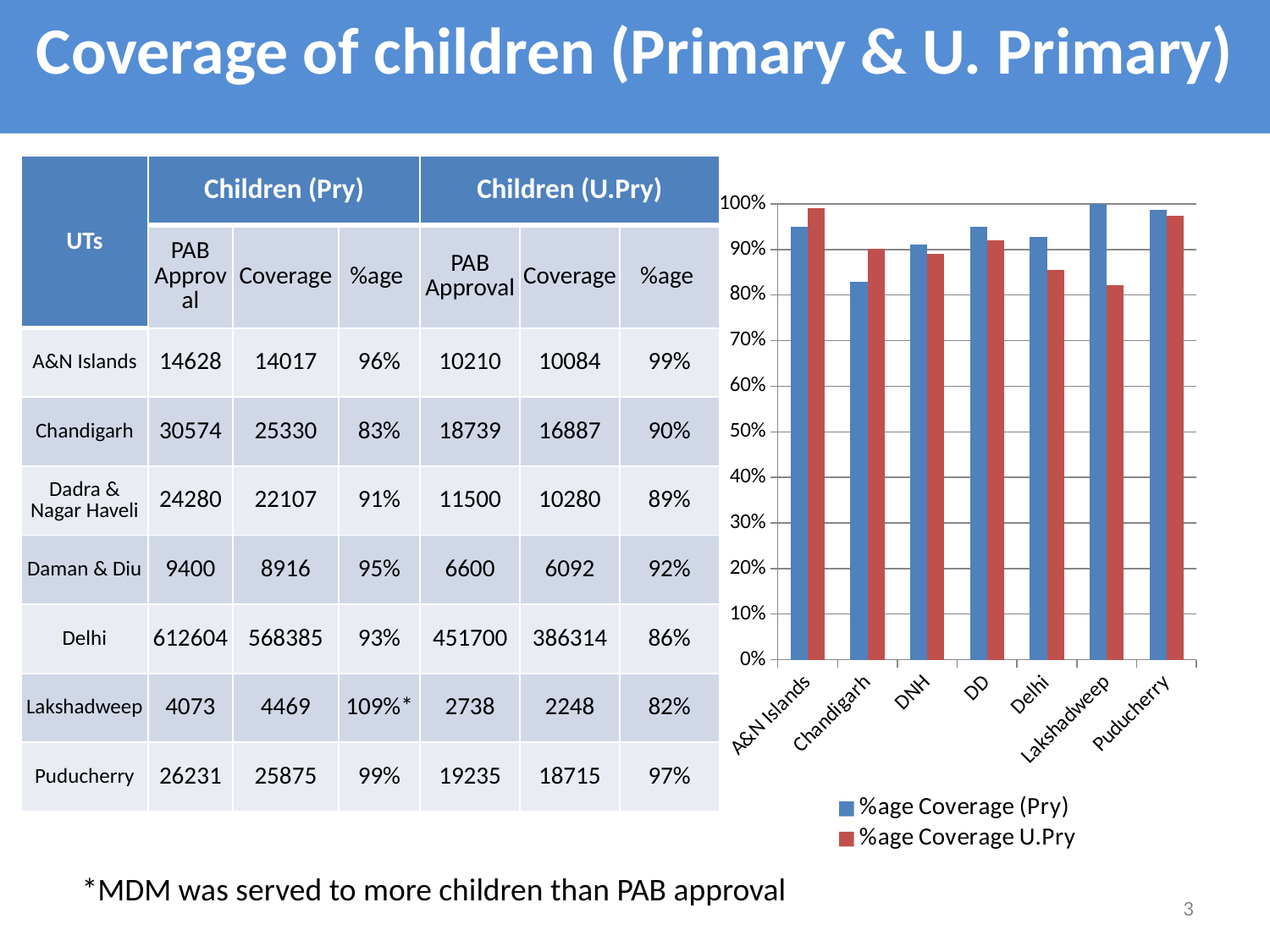
Which UT has the lowest bar for %age Coverage U.Pry? Lakshadweep Is the %age Coverage (Pry) value for Chandigarh greater or less than 90%? less For Lakshadweep, which is larger: %age Coverage (Pry) or %age Coverage U.Pry? %age Coverage (Pry) Is the %age Coverage (Pry) value for Puducherry greater or less than 90%? greater Which UT has the lowest bar for %age Coverage (Pry)? Chandigarh Is the %age Coverage U.Pry value for Delhi greater or less than 90%? less What kind of chart is shown on the slide? bar chart How many UTs (categories) are shown on the x axis of the chart? 7 For Chandigarh, which is larger: %age Coverage (Pry) or %age Coverage U.Pry? %age Coverage U.Pry What colour are the bars for the %age Coverage (Pry) series? blue How many series does the chart legend list? 2